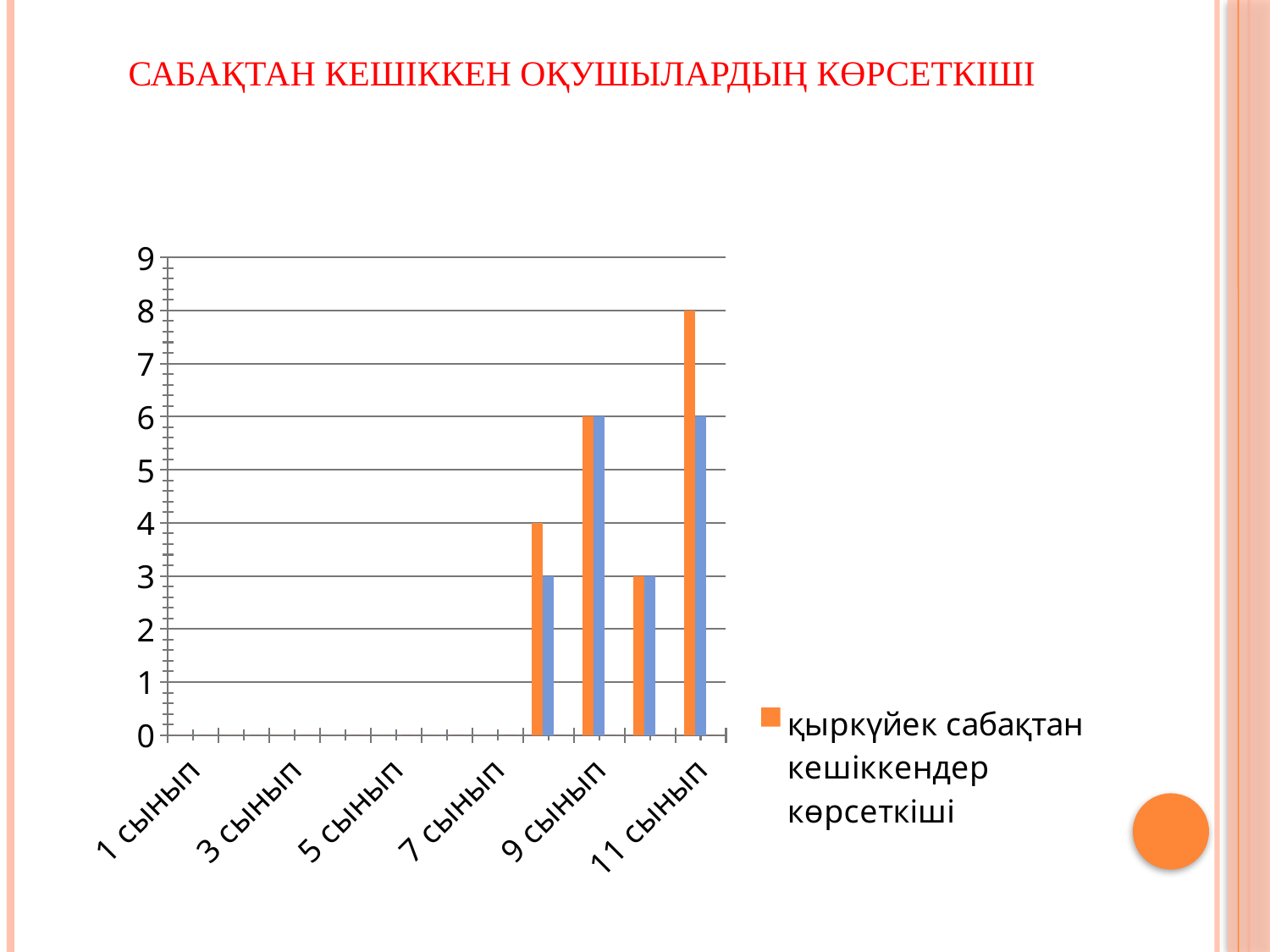
What is the value of the blue bar for 9 сынып? 6 What kind of chart is shown on the slide? bar chart What colour is the series named in the legend, "қыркүйек сабақтан кешіккендер көрсеткіші"? orange What is the value of the blue bar for 11 сынып? 6 What is the value of the orange bar for 11 сынып? 8 Is the value of the orange bar for 11 сынып greater or less than 7? greater What is the title of the slide above the chart? САБАҚТАН КЕШІККЕН ОҚУШЫЛАРДЫҢ КӨРСЕТКІШІ Which labelled category has the tallest orange bar? 11 сынып Which has the larger orange bar, 9 сынып or 11 сынып? 11 сынып What is the difference between the orange bars for 11 сынып and 9 сынып? 2 How many series does the legend list? 1 What is the value of the orange bar for 9 сынып? 6